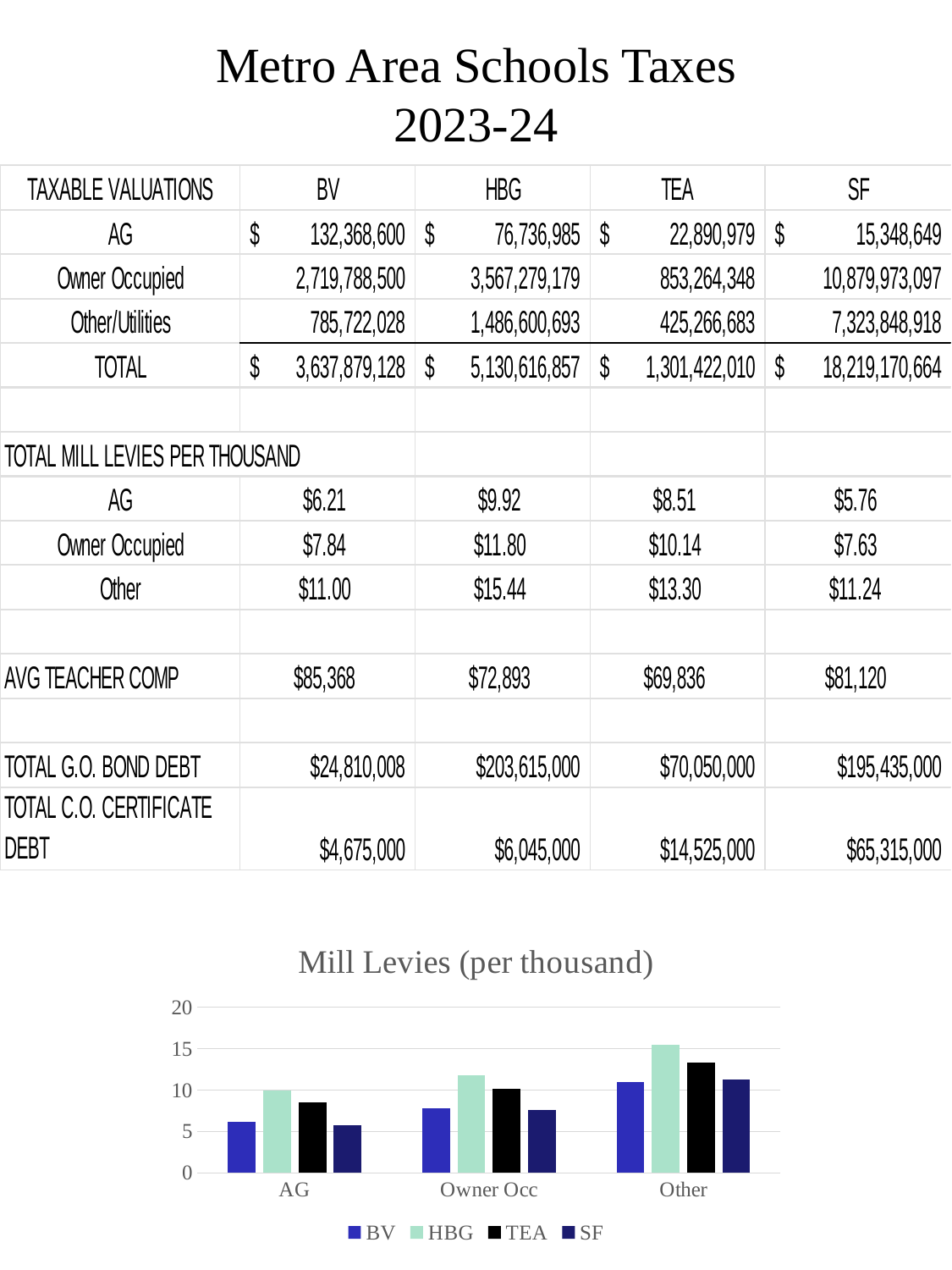
In the Mill Levies chart, do the HBG values rise or fall from AG to Other along the x axis? rise In the Mill Levies chart, which series has the highest bar in the Other category? HBG What is the title of the chart on the slide? Mill Levies (per thousand) In the Mill Levies chart, which series has the lowest bar in the AG category? SF How many categories are shown on the x axis of the Mill Levies chart? 3 In the Mill Levies chart, which series has the highest bar in the AG category? HBG How many series does the legend of the Mill Levies chart list? 4 In the Mill Levies chart, is the TEA value for Other greater or less than 15? less In the Mill Levies chart, is the SF value for Owner Occ greater or less than 10? less In the Mill Levies chart, is the HBG value for Owner Occ greater or less than 10? greater What kind of chart is shown under the title "Mill Levies (per thousand)"? bar chart In the Mill Levies chart, which is larger for the Other category: TEA or SF? TEA